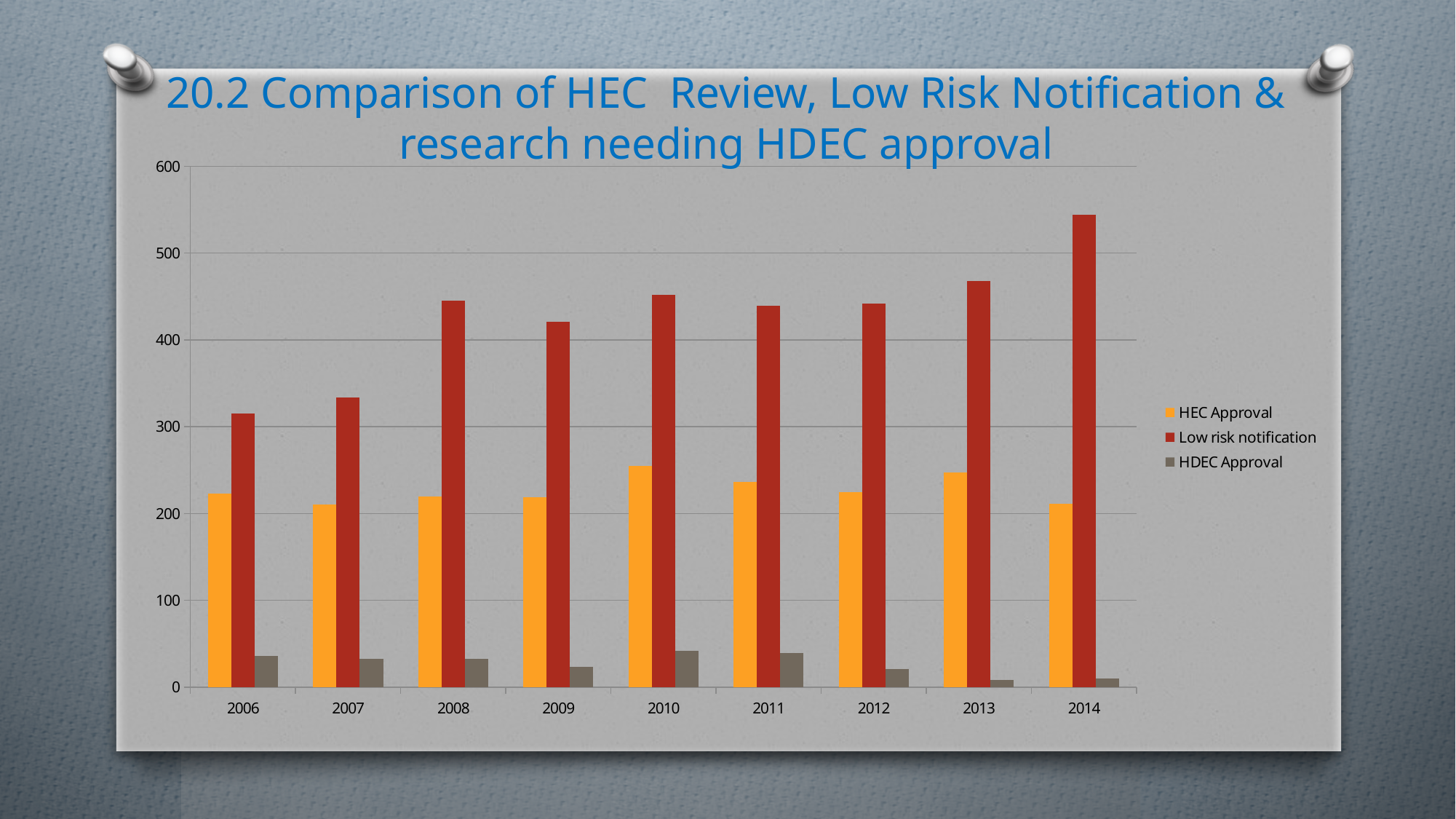
What colour are the Low risk notification bars? red How many series does the legend list? 3 In which year is the Low risk notification value lowest? 2006 Is the Low risk notification value for 2009 greater or less than 400? greater Does the Low risk notification series generally rise or fall from 2006 to 2014? rise Is the HEC Approval value for 2010 greater or less than 200? greater Is the Low risk notification value for 2014 greater or less than 500? greater How many years are shown on the x axis? 9 In which year is the Low risk notification value highest? 2014 What kind of chart is shown on the slide? bar chart Which is larger, the Low risk notification value for 2007 or for 2008? 2008